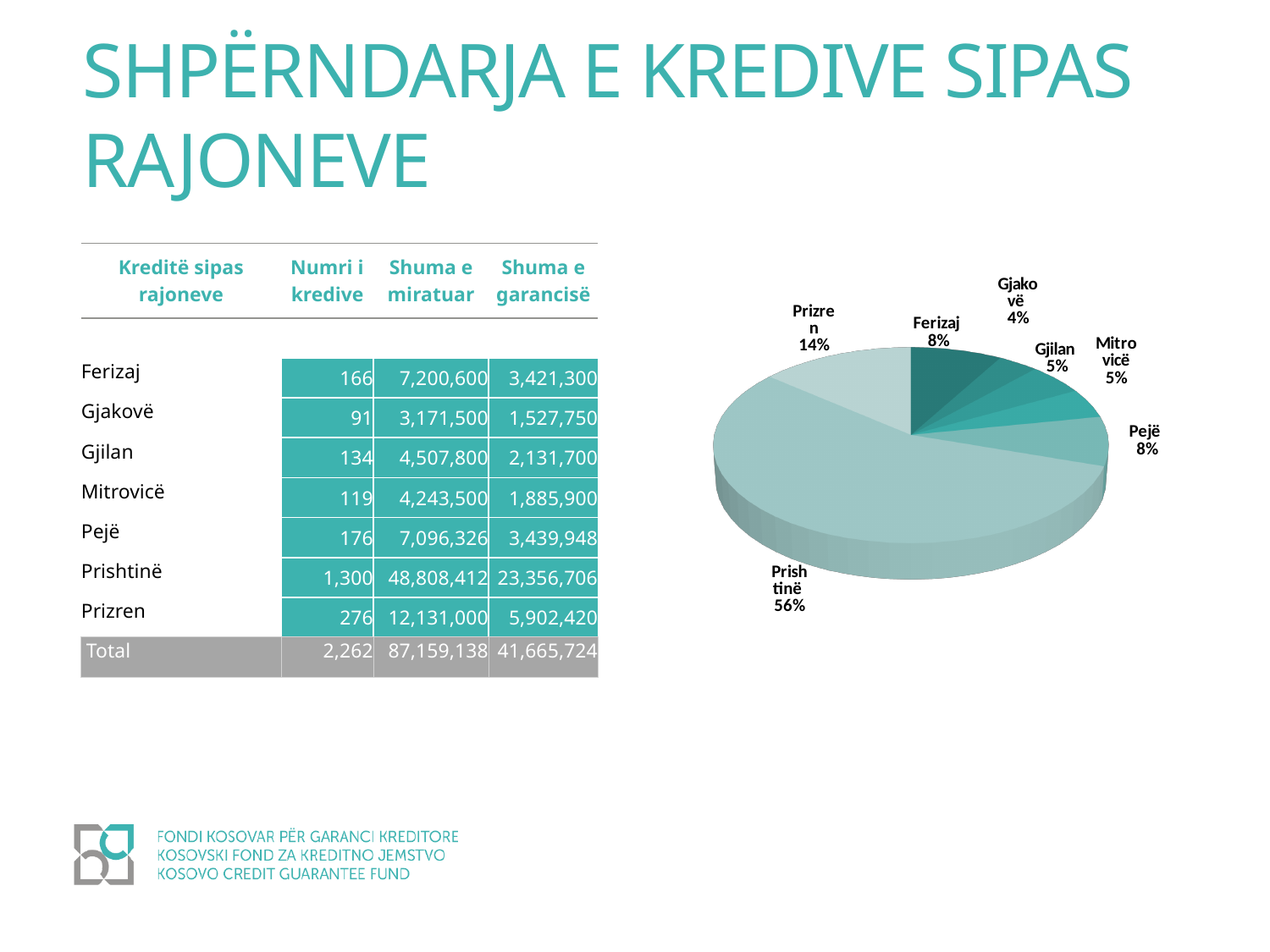
Which region has the smallest slice in the pie chart? Gjakovë What kind of chart is shown on the right of the slide? pie chart Which region has the largest slice in the pie chart? Prishtinë In the pie chart, what is the difference in percentage points between Pejë and Gjilan? 3 In the pie chart, what is the difference in percentage points between Prishtinë and Prizren? 42 In the pie chart, what share does Prishtinë have? 56% In the pie chart, what share does Ferizaj have? 8% How many slices does the pie chart have? 7 In the pie chart, what share does Prizren have? 14% In the pie chart, which slice is larger, Prizren or Pejë? Prizren